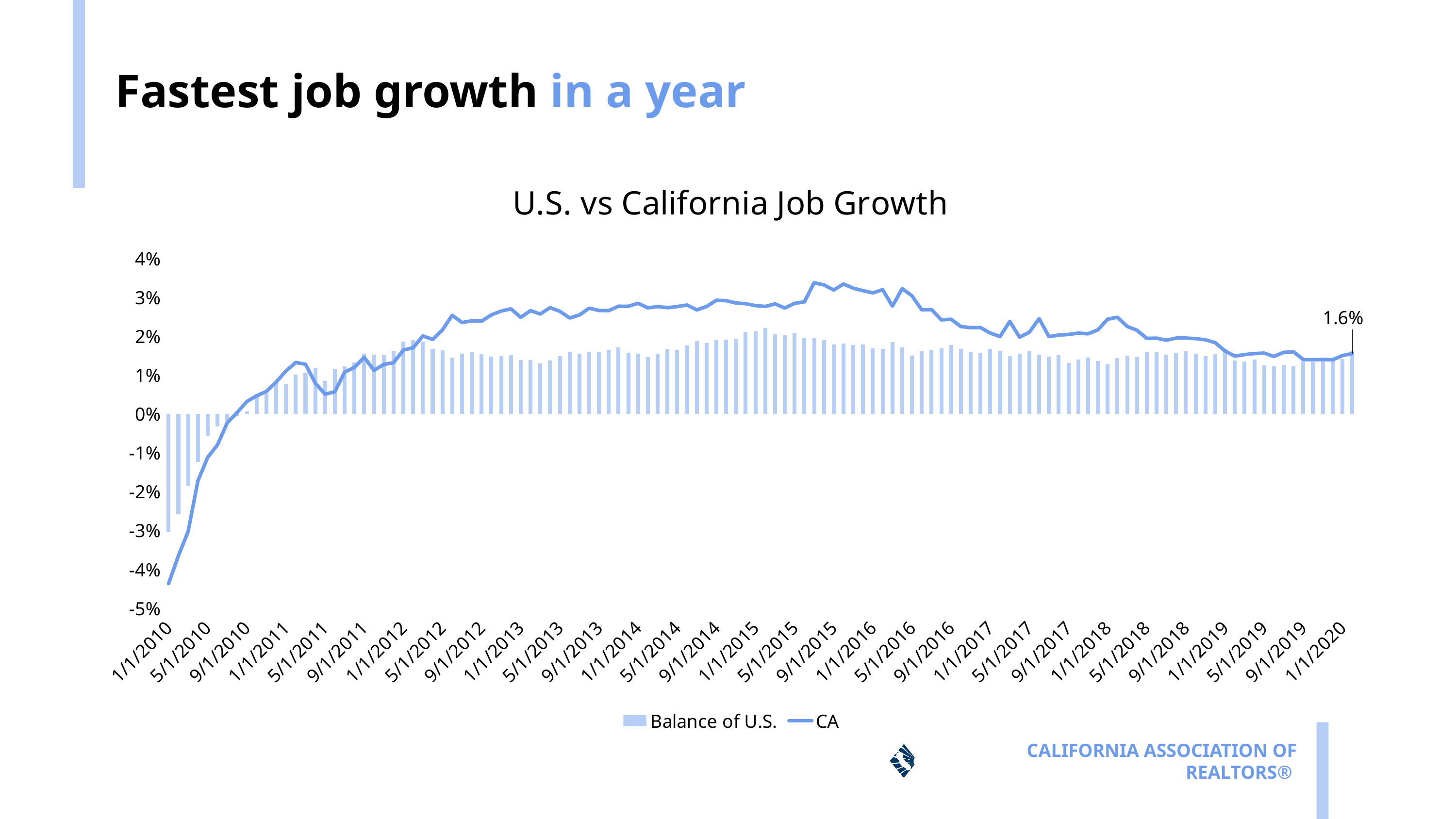
Is the Balance of U.S. value at 1/1/2020 greater or less than 1%? greater What kind of chart is shown on the slide? bar and line chart Is the CA value at 9/1/2015 greater or less than 3%? greater What are the two series named in the legend? Balance of U.S. and CA Is the Balance of U.S. value at 1/1/2010 greater or less than -2%? less Does the CA line rise or fall between 1/1/2010 and 1/1/2012? rise Does the CA line rise or fall between 9/1/2015 and 1/1/2020? fall How many series does the chart's legend list? 2 What is the title of the chart? U.S. vs California Job Growth At 9/1/2015, which series has the higher value, CA or Balance of U.S.? CA What is the CA job growth value labeled at 1/1/2020? 1.6%